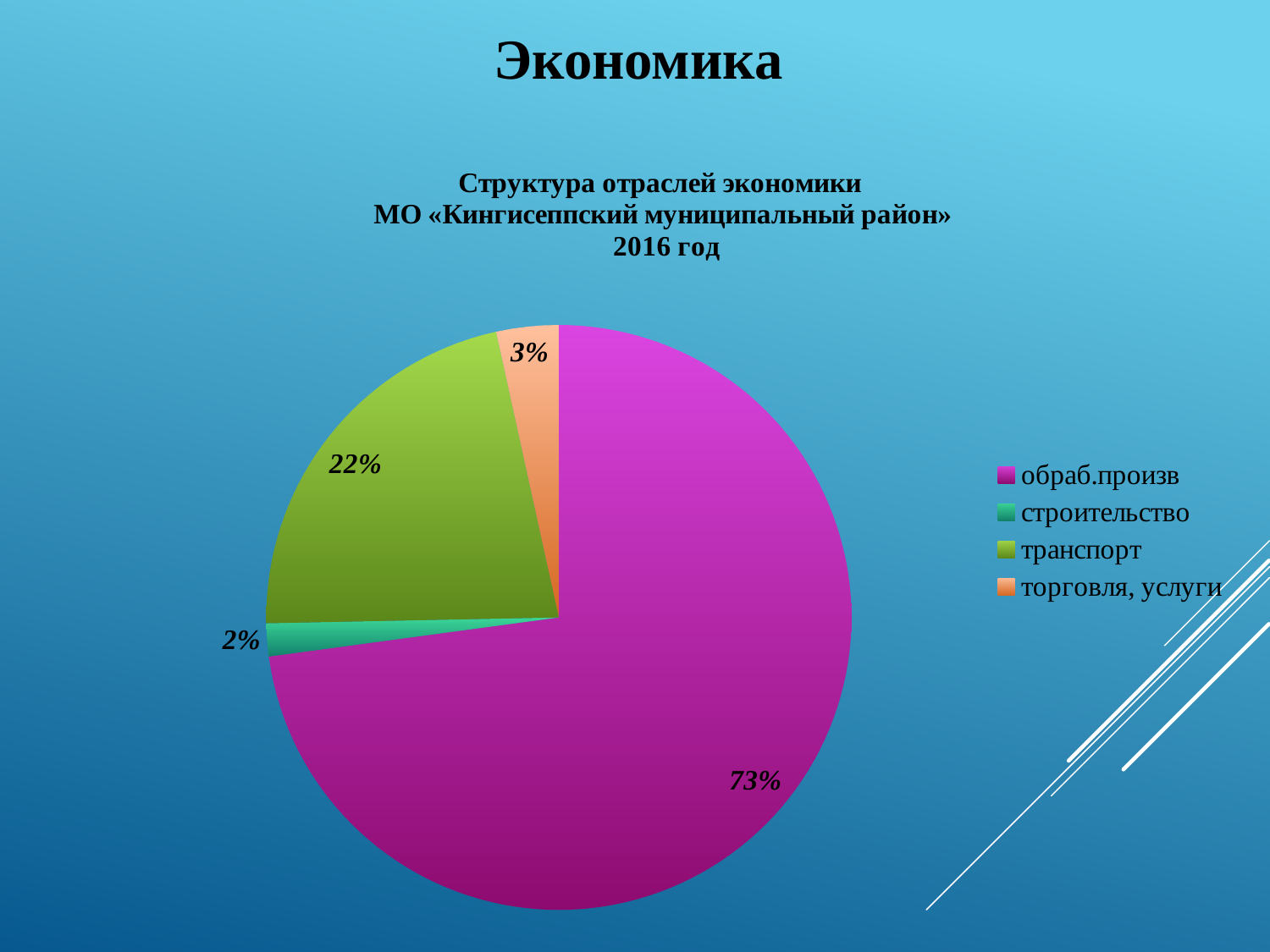
What share of the pie does обраб.произв have? 73% What share of the pie does строительство have? 2% Which category has the smallest slice of the pie? строительство How many categories are shown in the pie chart? 4 Which category has the largest slice of the pie? обраб.произв What share of the pie does транспорт have? 22% What is the difference in percentage points between обраб.произв and транспорт? 51 Which is larger, the share for транспорт or the share for торговля, услуги? транспорт What colour is the slice for транспорт? green What kind of chart is shown on the slide? pie chart What year does the chart title refer to? 2016